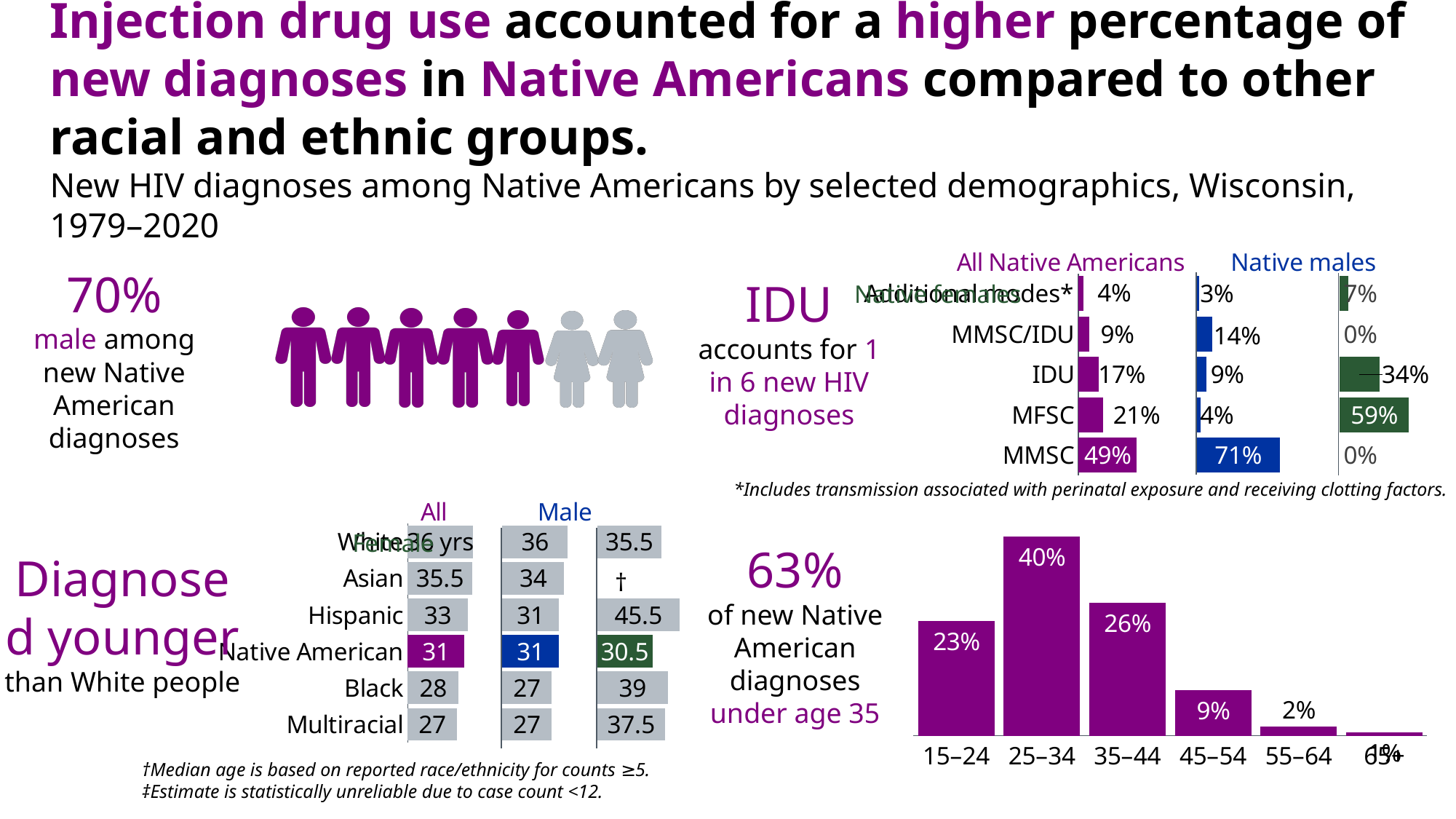
In the age group chart at the bottom right, what percentage of new Native American diagnoses is in the 35–44 age group? 26% How many series does the transmission category chart at the top right show? 3 In the transmission category chart at the top right, what is the difference in percentage points between MFSC and IDU for All Native Americans? 4 percentage points In the transmission category chart at the top right, what percentage of diagnoses among All Native Americans is attributed to MMSC? 49% In the age group chart at the bottom right, which age group has the highest percentage of new Native American diagnoses? 25–34 In the median age chart at the bottom middle, which racial/ethnic group has the lowest median age in the All column? Multiracial In the transmission category chart at the top right, which transmission category has the highest percentage for Native males? MMSC In the transmission category chart at the top right, which is larger for MMSC/IDU: the Native males value or the All Native Americans value? Native males In the transmission category chart at the top right, what percentage of diagnoses among Native males is attributed to IDU? 9% In the median age chart at the bottom middle, what is the median age for Hispanic females? 45.5 In the age group chart at the bottom right, what is the difference in percentage points between the 25–34 and 15–24 age groups? 17 percentage points In the transmission category chart at the top right, what percentage of diagnoses among Native females is attributed to MFSC? 59%